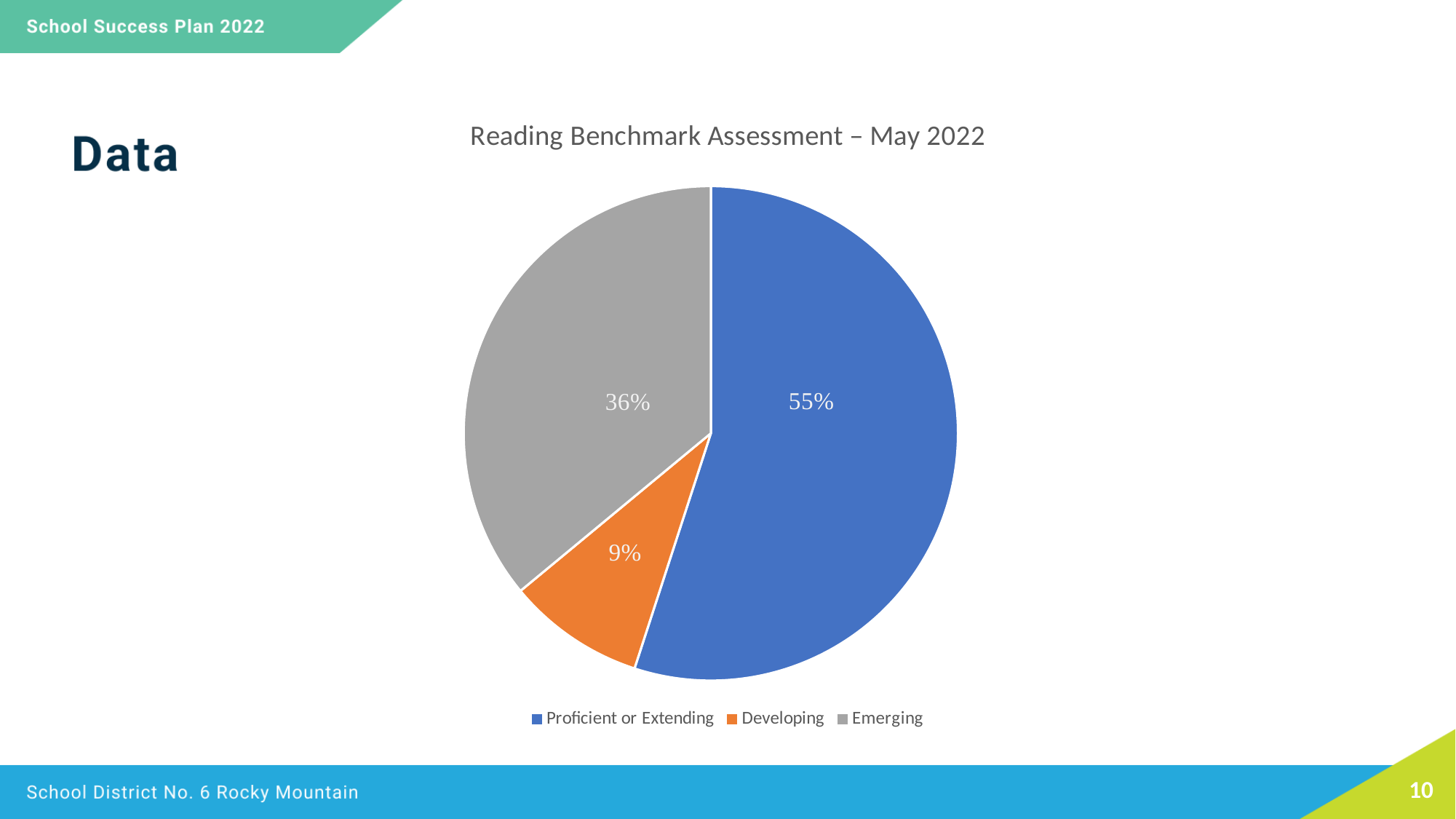
What percentage of the pie is Emerging? 36% Which colour represents Developing in the chart? orange Which category has the largest share of the pie? Proficient or Extending What is the title of the chart? Reading Benchmark Assessment – May 2022 What is the difference in percentage points between Proficient or Extending and Emerging? 19 Which is larger, the Emerging share or the Developing share? Emerging Which category has the smallest share of the pie? Developing What is the difference in percentage points between Emerging and Developing? 27 What percentage of the pie is Developing? 9% What type of chart is shown on the slide? pie chart What percentage of the pie is Proficient or Extending? 55% How many categories does the pie chart show? 3